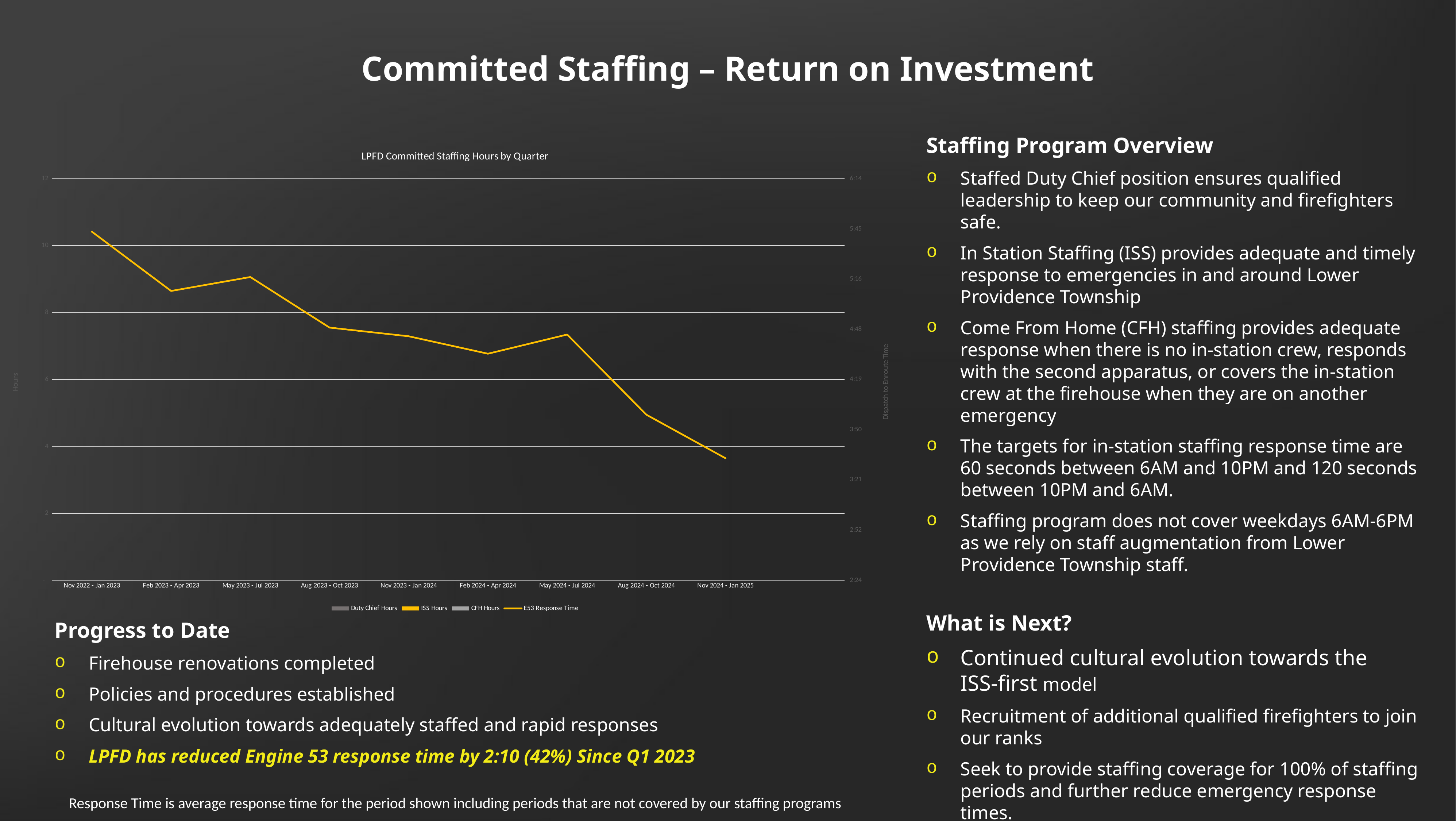
Measured against the left-hand Hours axis, is the plotted line at Nov 2024 - Jan 2025 greater or less than 4? less Does the plotted line generally rise or fall from Nov 2022 - Jan 2023 to Nov 2024 - Jan 2025? fall How many series does the chart's legend list? 4 Is the plotted line higher at Feb 2024 - Apr 2024 or at May 2024 - Jul 2024? May 2024 - Jul 2024 Is the plotted line higher at Aug 2024 - Oct 2024 or at Nov 2024 - Jan 2025? Aug 2024 - Oct 2024 At which quarter does the plotted line reach its highest point? Nov 2022 - Jan 2023 Measured against the left-hand Hours axis, is the plotted line at Nov 2022 - Jan 2023 greater or less than 10? greater How many quarters are shown along the x axis of the chart? 9 What kind of chart is shown on the slide? line chart What is the title of the chart on the slide? LPFD Committed Staffing Hours by Quarter At which quarter does the plotted line reach its lowest point? Nov 2024 - Jan 2025 Which quarter is the first category on the x axis of the chart? Nov 2022 - Jan 2023